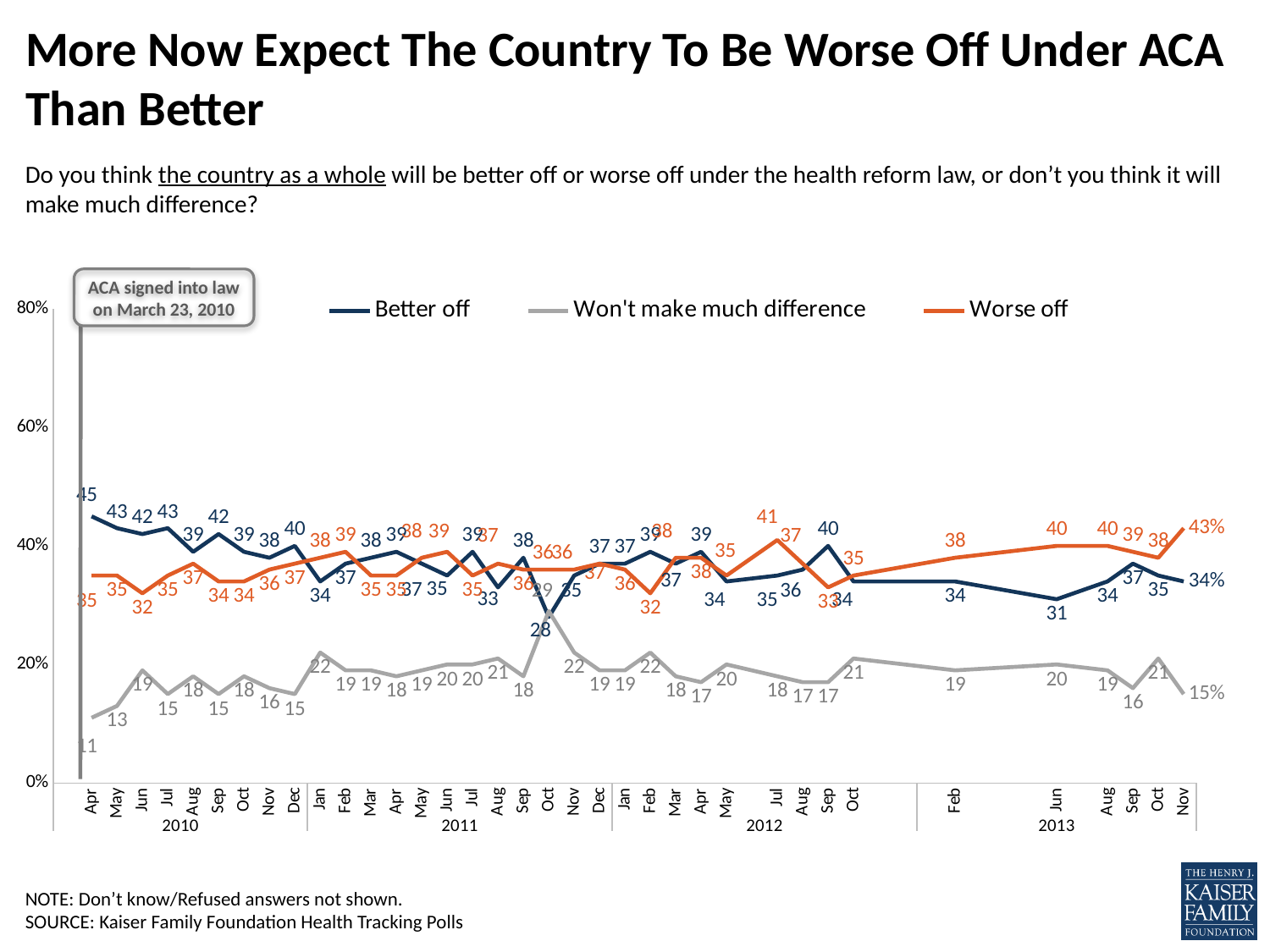
In Nov 2013, how many percentage points higher is 'Worse off' than 'Better off'? 9 What is the lowest value plotted for the 'Better off' series? 28 What type of chart is shown on the slide? Line chart How many series does the chart's legend list? 3 Is the value for 'Better off' in Apr 2010 greater or less than 40%? greater What is the value for 'Worse off' in Jul 2012? 41 What is the value for 'Won't make much difference' in Nov 2013? 15% What is the value for 'Better off' in Apr 2010? 45 What is the value for 'Better off' in Oct 2011? 28 In Jun 2013, which is larger: 'Better off' or 'Worse off'? Worse off What does the annotation box at the start of the chart say? ACA signed into law on March 23, 2010 What is the value for 'Worse off' in Nov 2013? 43%